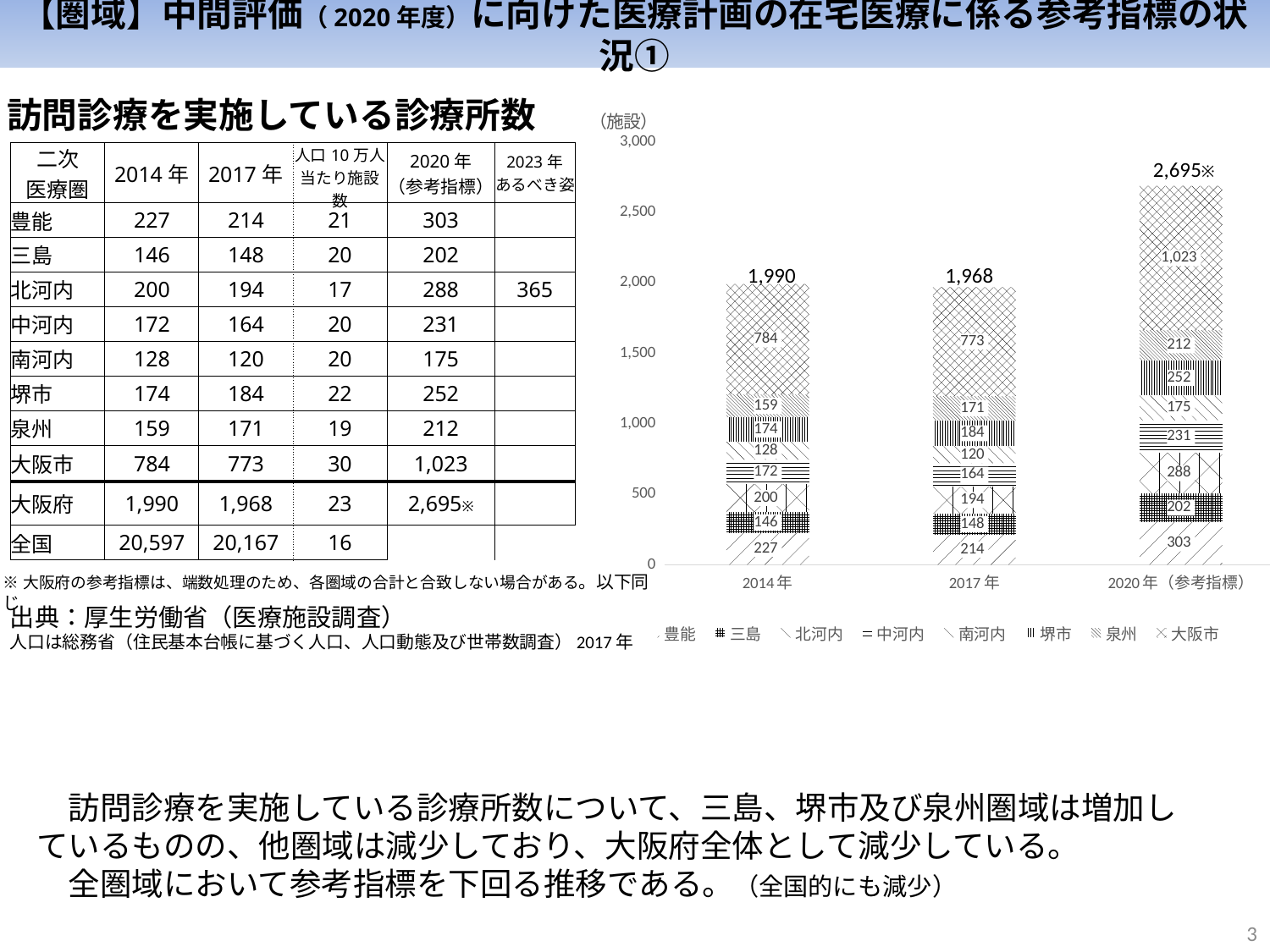
Which is larger: the 泉州 segment in 2014年 or the 泉州 segment in 2017年? 2017年 How many bars (categories) are plotted on the x axis of the chart? 3 What is the total shown above the 2020年（参考指標） bar in the chart? 2,695※ What is the value of the 豊能 segment in the 2020年（参考指標） bar? 303 Which bar has the lowest total in the chart? 2017年 How many series does the chart legend list? 8 What is the value of the 大阪市 segment in the 2017年 bar? 773 What is the total shown above the 2014年 bar in the chart? 1,990 What is the value of the 堺市 segment in the 2014年 bar? 174 What type of chart is shown on the slide? stacked bar chart What is the difference between the 大阪市 segment in the 2020年（参考指標） bar and the 大阪市 segment in the 2014年 bar? 239 Which bar has the highest total in the chart? 2020年（参考指標）